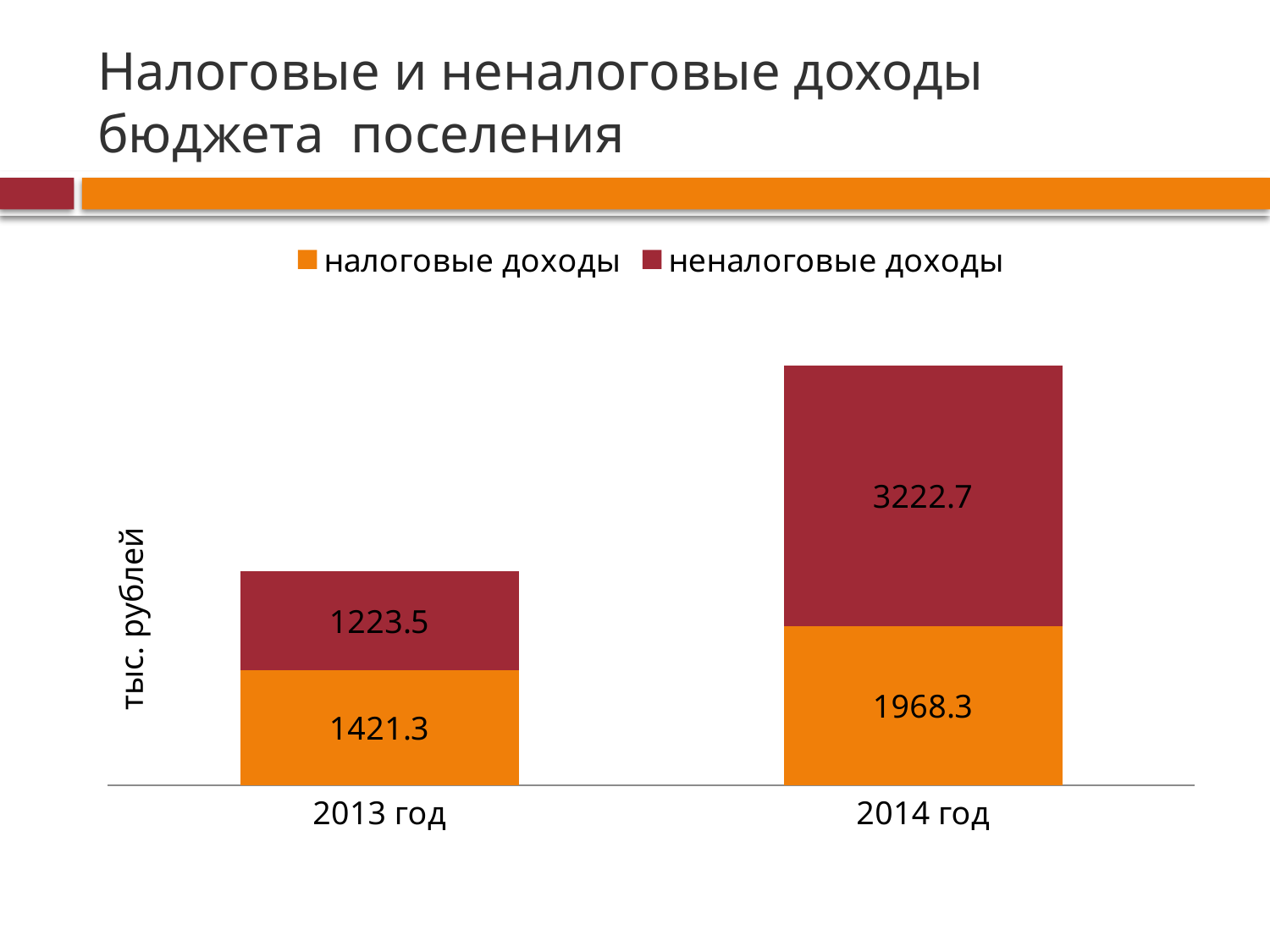
What is the difference between неналоговые доходы in 2014 год and 2013 год? 1999.2 Which year has the higher value of неналоговые доходы? 2014 год What is the total of the stacked bar for 2014 год? 5191.0 What is the value of неналоговые доходы for 2013 год? 1223.5 In 2014 год, which is larger: налоговые доходы or неналоговые доходы? неналоговые доходы What is the value of неналоговые доходы for 2014 год? 3222.7 What kind of chart is shown on the slide? stacked bar chart What is the value of налоговые доходы for 2013 год? 1421.3 What is the difference between налоговые доходы in 2014 год and 2013 год? 547.0 How many series does the legend list? 2 What is the value of налоговые доходы for 2014 год? 1968.3 What is the total of the stacked bar for 2013 год? 2644.8